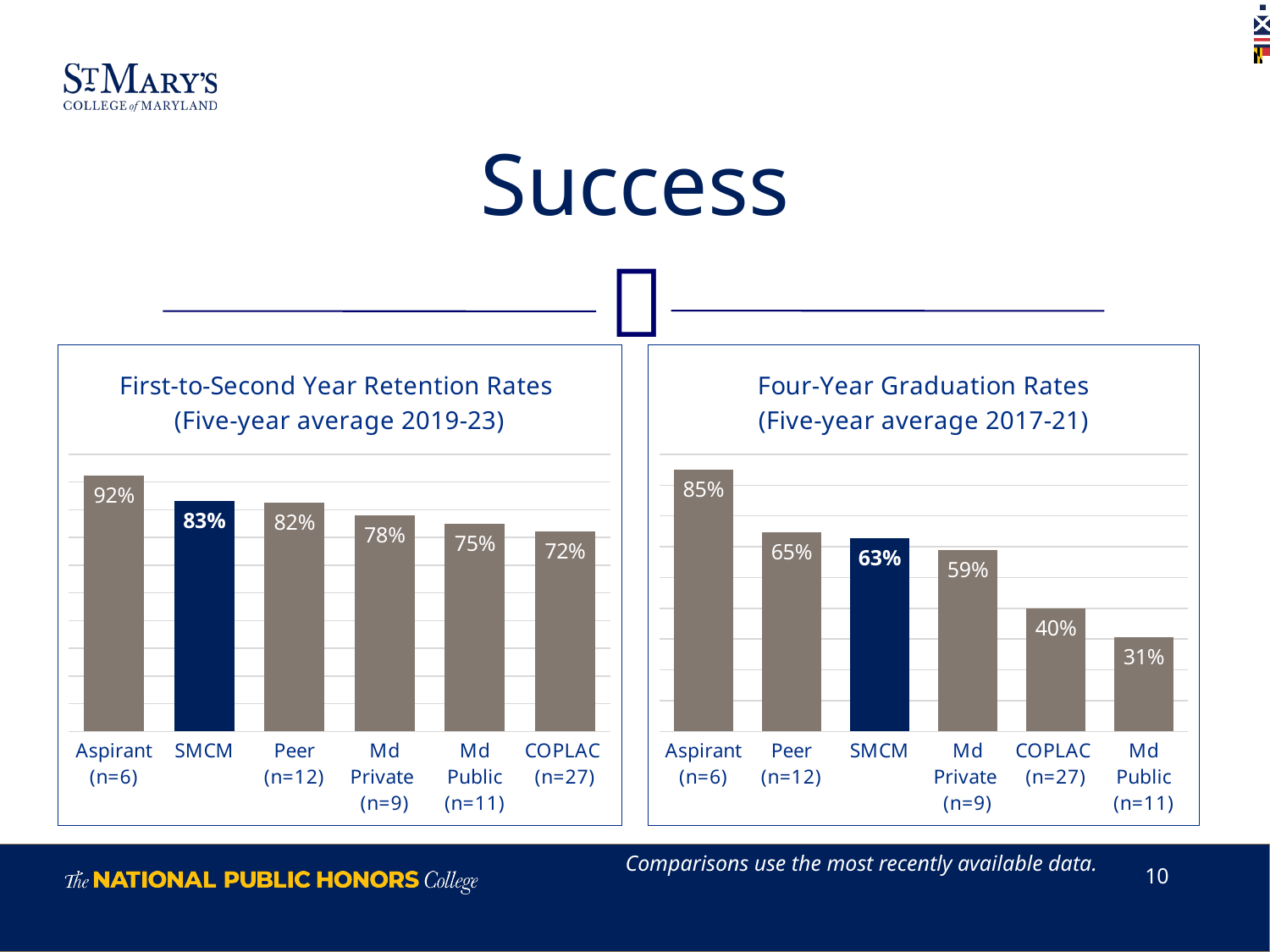
In the First-to-Second Year Retention Rates chart, how many categories are shown? 6 In the First-to-Second Year Retention Rates chart, what is the value for SMCM? 83% In the First-to-Second Year Retention Rates chart, what is the difference between the Aspirant value and the SMCM value? 9% In the Four-Year Graduation Rates chart, what is the value for Md Private? 59% In the Four-Year Graduation Rates chart, which is larger, the value for Peer or the value for SMCM? Peer What kind of chart is the Four-Year Graduation Rates chart? bar chart In the Four-Year Graduation Rates chart, which category has the lowest value? Md Public (n=11) In the First-to-Second Year Retention Rates chart, which category has the lowest value? COPLAC (n=27) In the First-to-Second Year Retention Rates chart, which bar is coloured dark blue rather than grey? SMCM In the First-to-Second Year Retention Rates chart, which category has the highest value? Aspirant (n=6) In the Four-Year Graduation Rates chart, do the values rise or fall from left to right? fall In the Four-Year Graduation Rates chart, what is the difference between the COPLAC value and the Md Public value? 9%